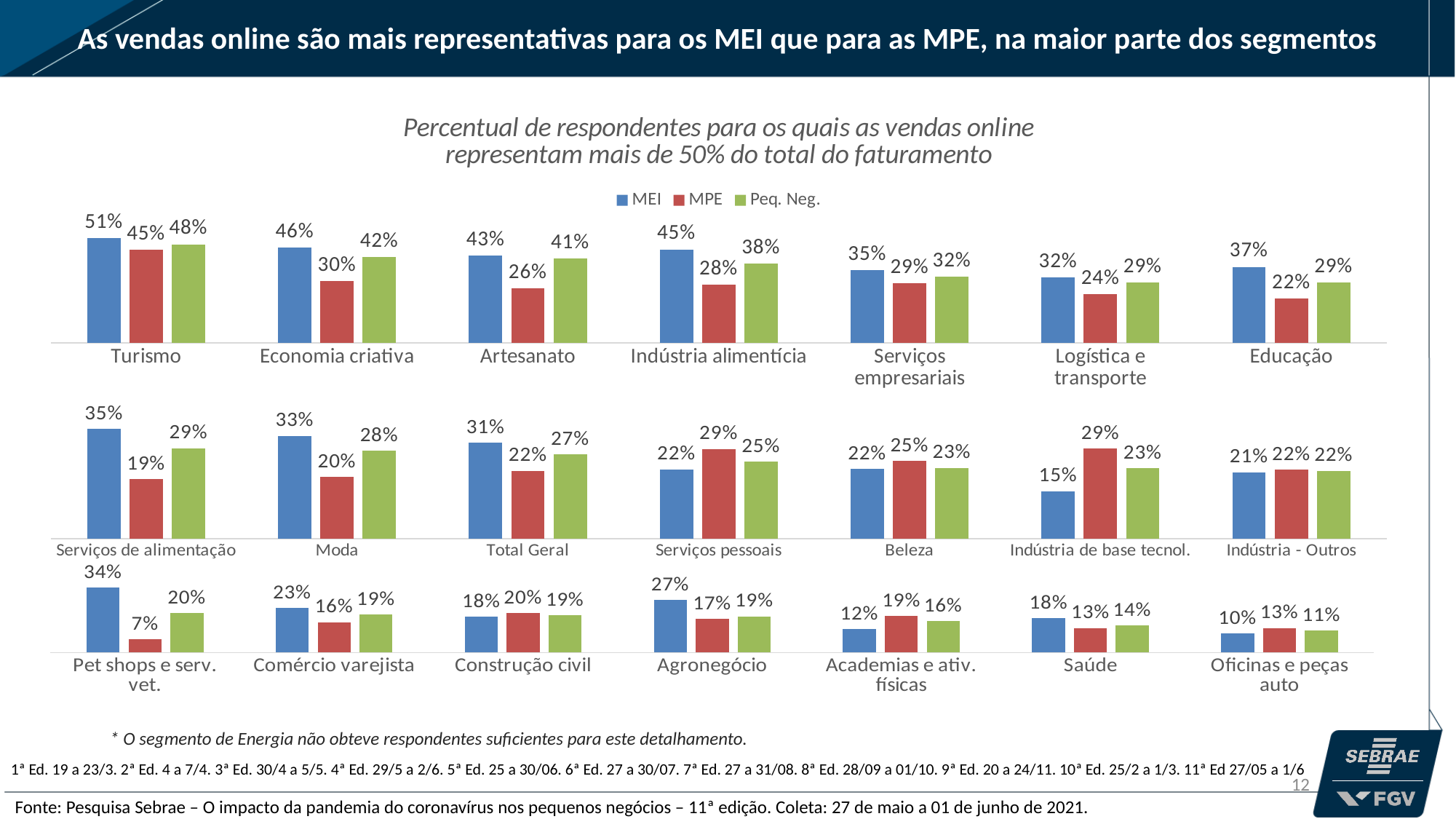
What is the Peq. Neg. value for Total Geral? 27% For Serviços pessoais, which is larger: the MEI value or the MPE value? MPE What is the MPE value for Indústria de base tecnol.? 29% Which segment has the highest MEI value? Turismo How many segments are shown in the top row of the chart? 7 Which segment has the lowest MPE value? Pet shops e serv. vet. What is the difference between the MEI and MPE values for Economia criativa? 16% How many series does the legend list? 3 What kind of chart is shown on the slide? Bar chart What is the MPE value for Pet shops e serv. vet.? 7% What is the MEI value for Turismo? 51% Which colour represents the MPE series in the legend? Red